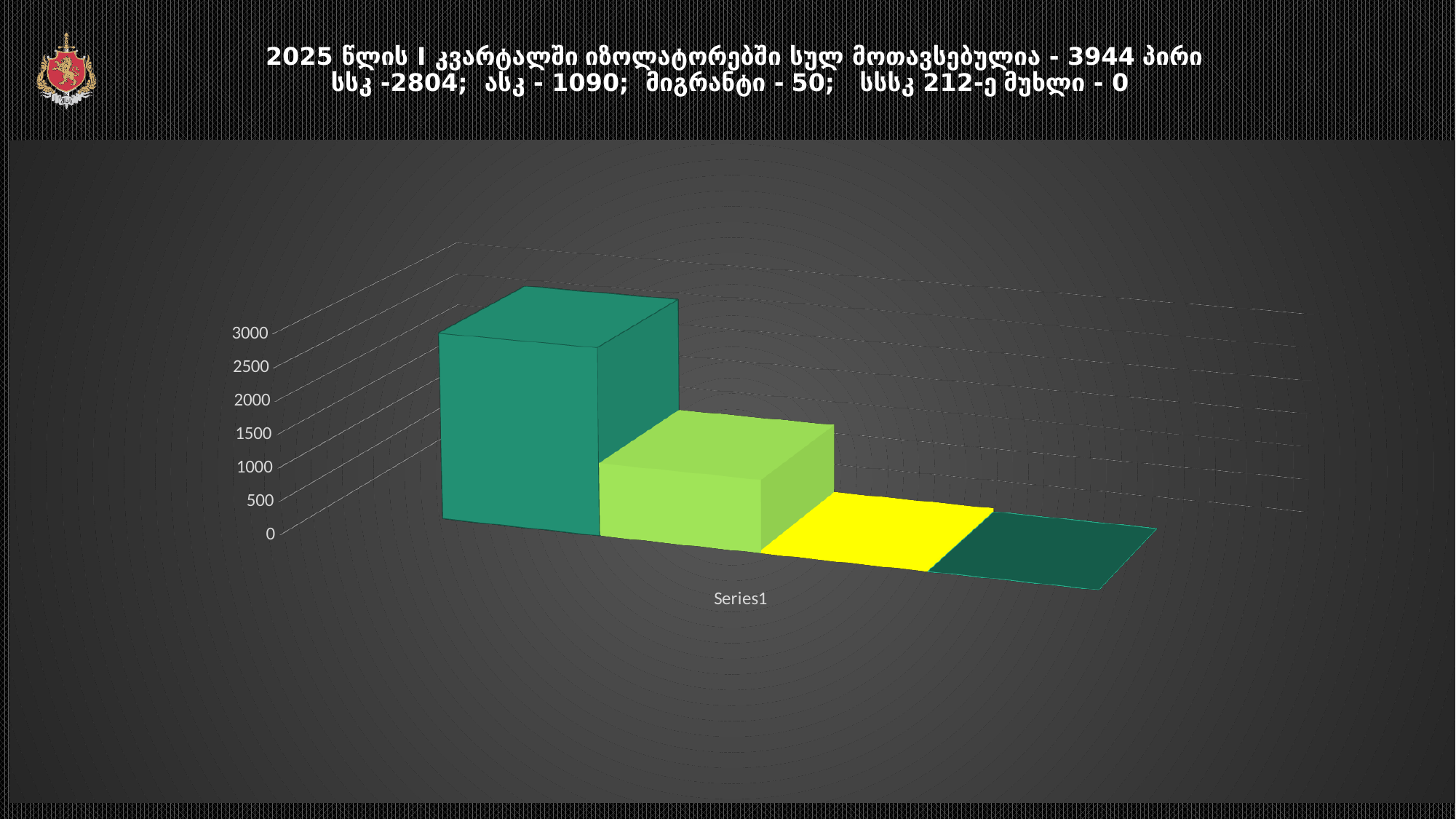
Is the tallest (leftmost) bar greater or less than 2500? greater Do the bar heights rise or fall from left to right? fall According to the slide title, what is the value for ასკ? 1090 What is the difference between the values for სსკ and ასკ? 1714 Which category has the highest value on the slide? სსკ How many bars are plotted in the chart? 4 According to the slide title, what is the value for სსსკ 212-ე მუხლი? 0 According to the slide title, what is the value for სსკ? 2804 Is the second bar from the left greater or less than 1500? less According to the slide title, what is the value for მიგრანტი? 50 What kind of chart is shown on the slide? bar chart What is the total number of persons placed in isolators in Q1 2025, as stated on the slide? 3944